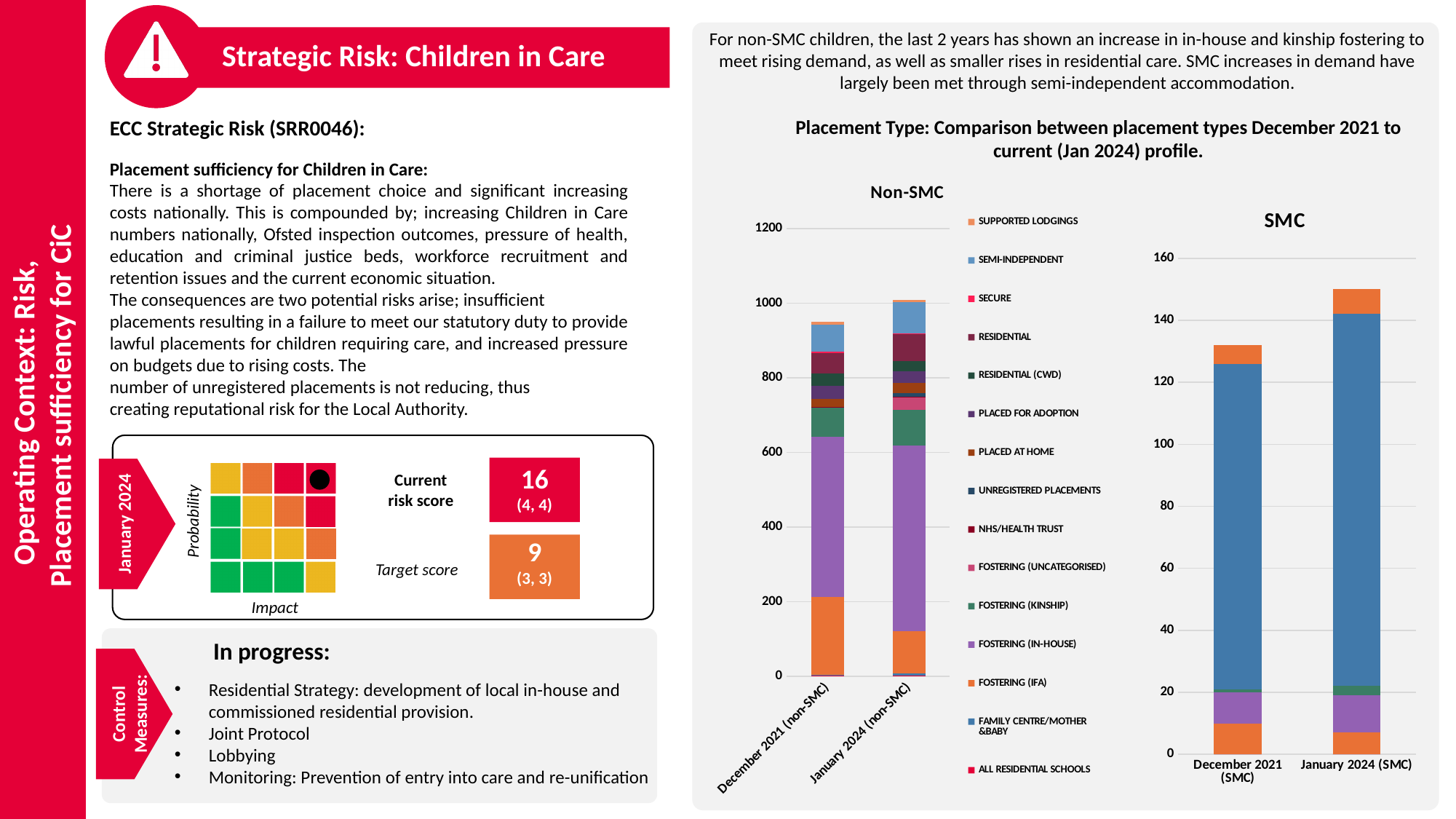
What is the highest value shown on the y axis of the SMC chart? 160 In the SMC chart, is the total for December 2021 (SMC) greater or less than 120? greater In the SMC chart, which bar has the higher total, December 2021 (SMC) or January 2024 (SMC)? January 2024 (SMC) In the Non-SMC chart, is the total for December 2021 (non-SMC) greater or less than 1000? less In the SMC chart, is the total for January 2024 (SMC) greater or less than 140? greater In the Non-SMC chart, which bar has the higher total, December 2021 (non-SMC) or January 2024 (non-SMC)? January 2024 (non-SMC) What is the title of the chart section on the right of the slide? Placement Type: Comparison between placement types December 2021 to current (Jan 2024) profile. What kind of chart is the Non-SMC chart? stacked bar chart How many bars (time points) does the Non-SMC chart show? 2 In the SMC chart, do the totals rise or fall from December 2021 to January 2024? rise How many series does the legend of the Non-SMC chart list? 15